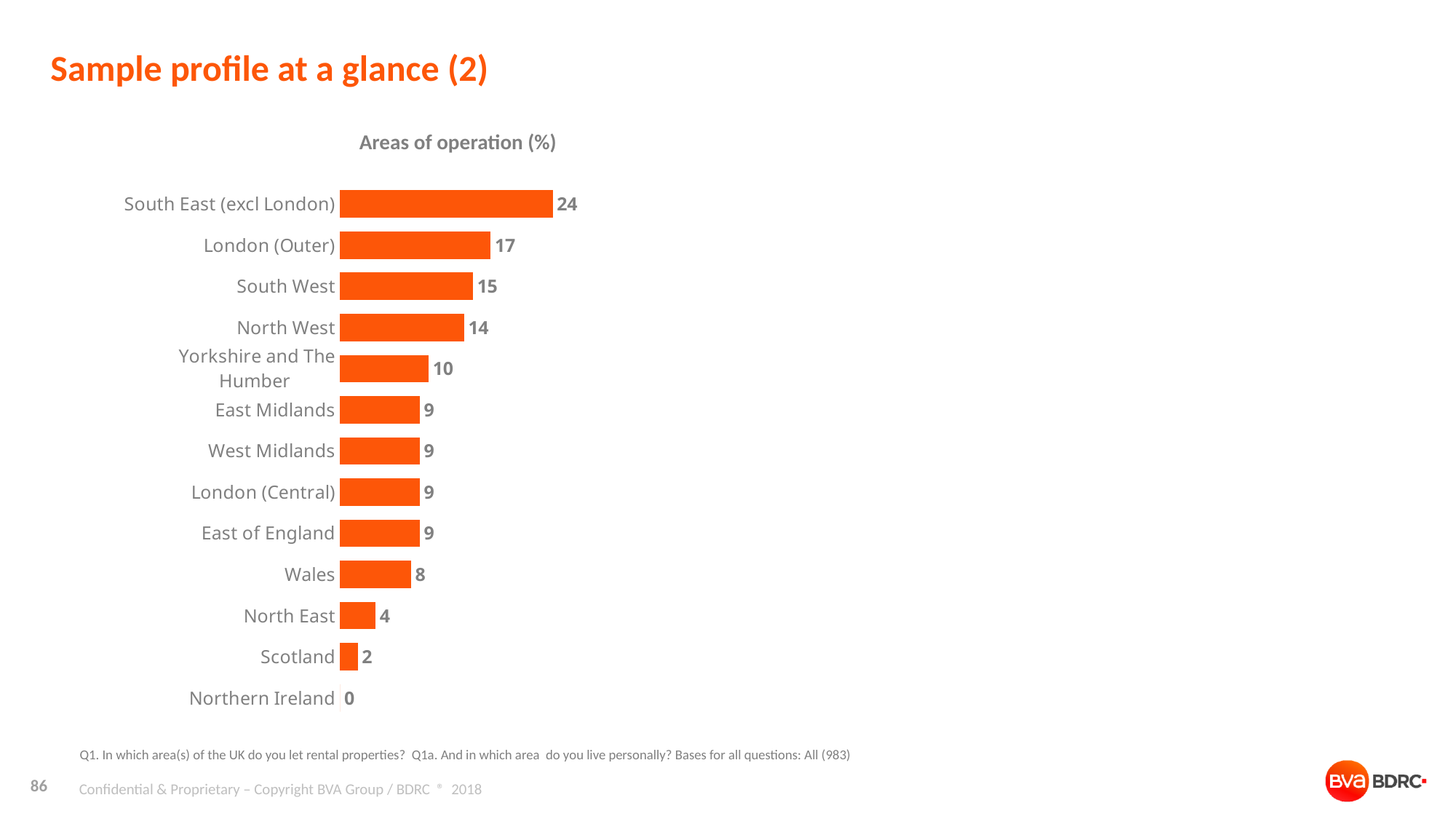
How many areas are shown in the chart? 13 Which area has the lowest value? Northern Ireland What is the value for South East (excl London)? 24 What is the difference between the values for London (Outer) and London (Central)? 8 What is the title of the chart? Areas of operation (%) What kind of chart is shown on the slide? Bar chart What colour are the bars in the chart? Orange What is the difference between the values for South West and North East? 11 Which is larger, the value for North West or the value for Scotland? North West What is the value for Yorkshire and The Humber? 10 Which area has the highest value? South East (excl London) What is the value for Wales? 8